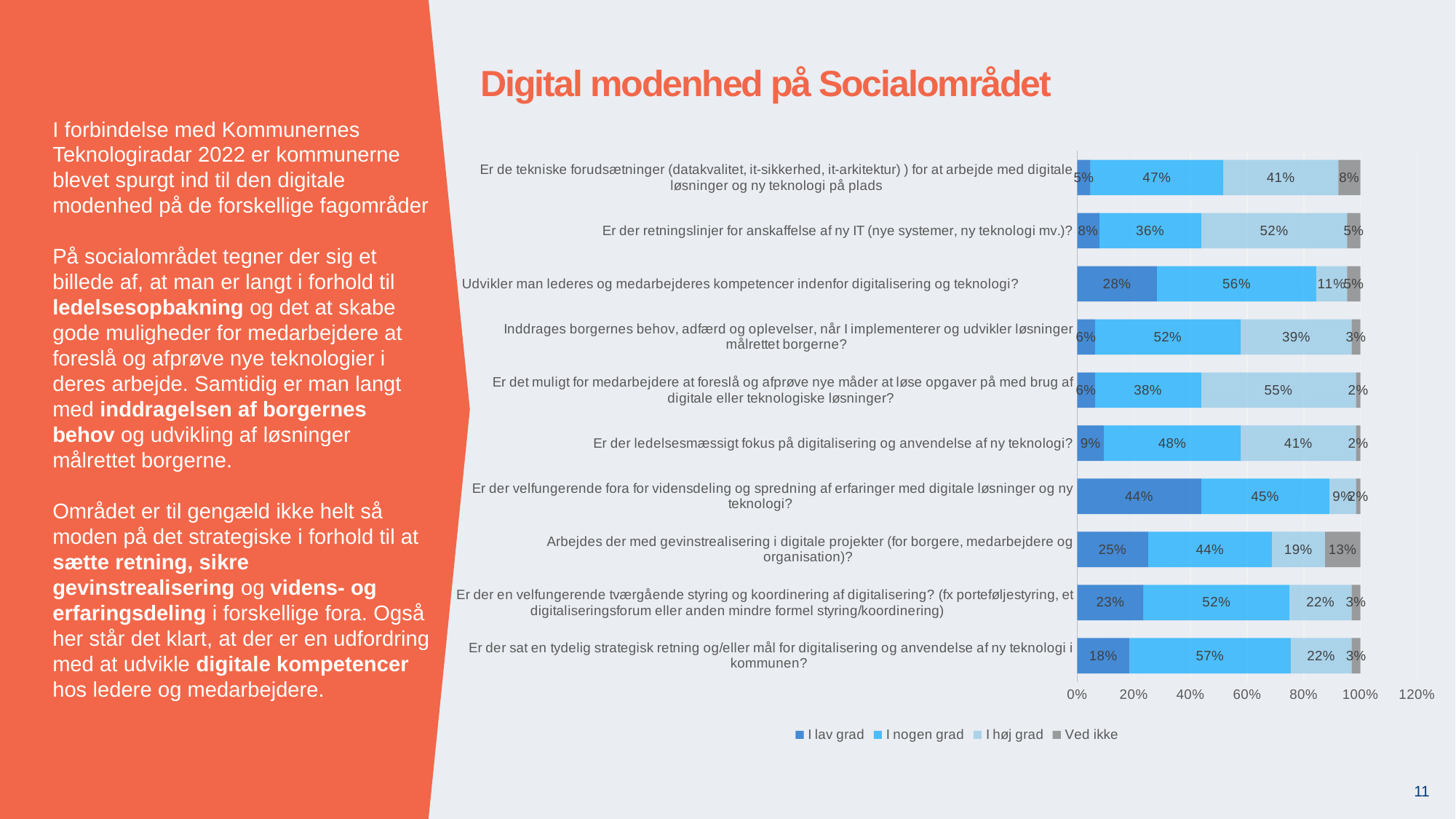
Which question has the highest 'I lav grad' value? Er der velfungerende fora for vidensdeling og spredning af erfaringer med digitale løsninger og ny teknologi? What is the title of the chart? Digital modenhed på Socialområdet What is the 'I høj grad' value for 'Er det muligt for medarbejdere at foreslå og afprøve nye måder at løse opgaver på med brug af digitale eller teknologiske løsninger?' 55% What is the difference between the 'I nogen grad' and 'I høj grad' values for 'Udvikler man lederes og medarbejderes kompetencer indenfor digitalisering og teknologi?' 45% How many series does the legend list? 4 Which question has the lowest 'I høj grad' value? Er der velfungerende fora for vidensdeling og spredning af erfaringer med digitale løsninger og ny teknologi? What is the combined 'I lav grad' and 'I nogen grad' share for 'Er der en velfungerende tværgående styring og koordinering af digitalisering?' 75% Which is larger for 'Er der retningslinjer for anskaffelse af ny IT (nye systemer, ny teknologi mv.)?': the 'I nogen grad' value or the 'I høj grad' value? I høj grad What is the 'I nogen grad' value for 'Er der sat en tydelig strategisk retning og/eller mål for digitalisering og anvendelse af ny teknologi i kommunen?' 57% What is the 'Ved ikke' value for 'Arbejdes der med gevinstrealisering i digitale projekter (for borgere, medarbejdere og organisation)?' 13% What kind of chart is shown on the slide? Stacked bar chart How many questions (categories) are plotted in the chart? 10